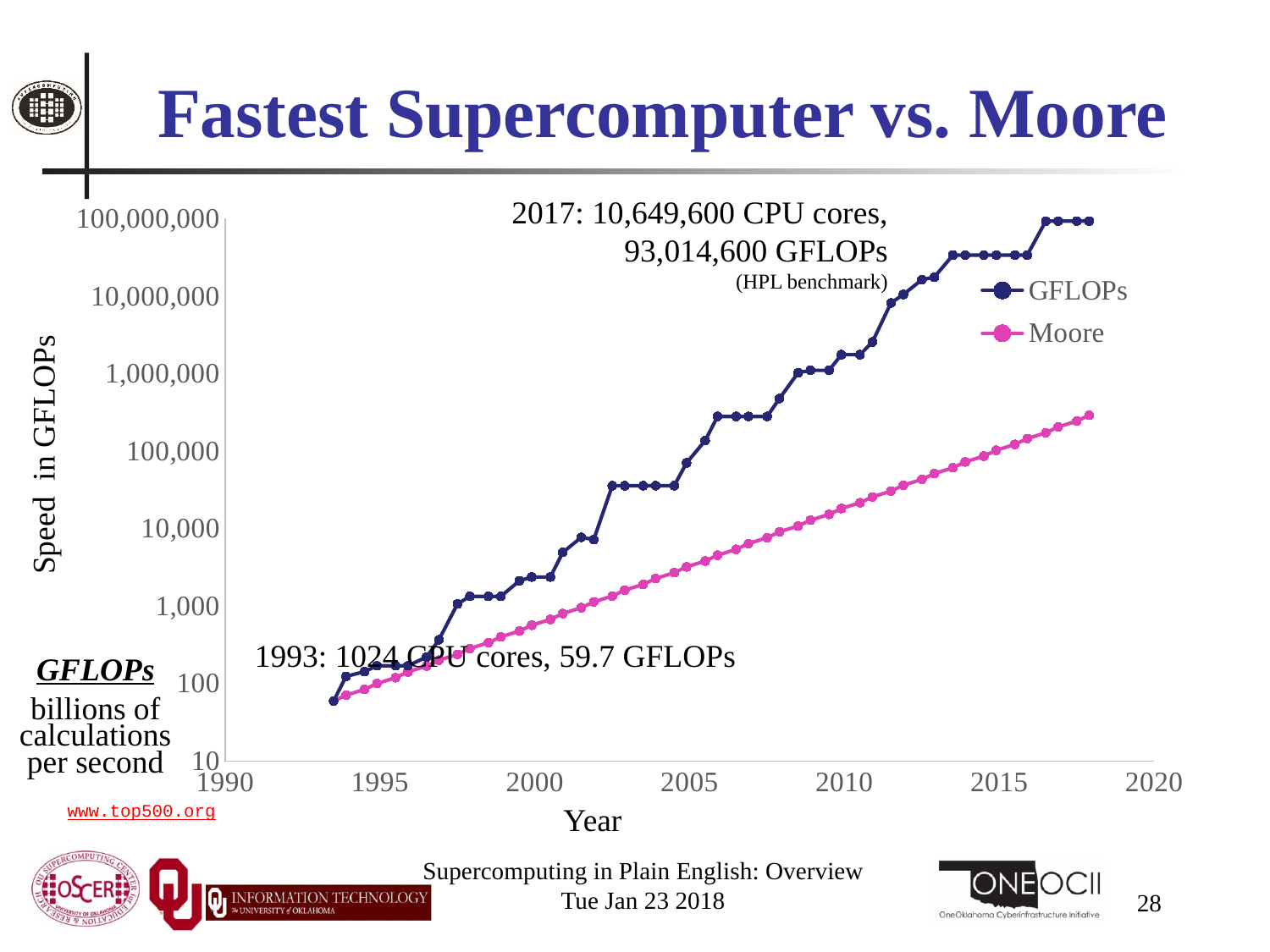
According to the annotation, what was the speed of the fastest supercomputer in 2017? 93,014,600 GFLOPs According to the annotation, what was the speed of the fastest supercomputer in 1993? 59.7 GFLOPs Is the GFLOPs value in 2005 greater or less than 10,000? greater How many series does the legend list? 2 Does the GFLOPs series rise or fall as the year increases? rise What are the two series named in the legend? GFLOPs and Moore In 2015, which series has the higher value, GFLOPs or Moore? GFLOPs Is the Moore value in 2018 greater or less than 1,000,000? less What kind of chart is shown on the slide? line chart Is the GFLOPs value in 2017 greater or less than 10,000,000? greater What is the title of the chart? Fastest Supercomputer vs. Moore How many CPU cores did the fastest supercomputer have in 2017, according to the annotation? 10,649,600